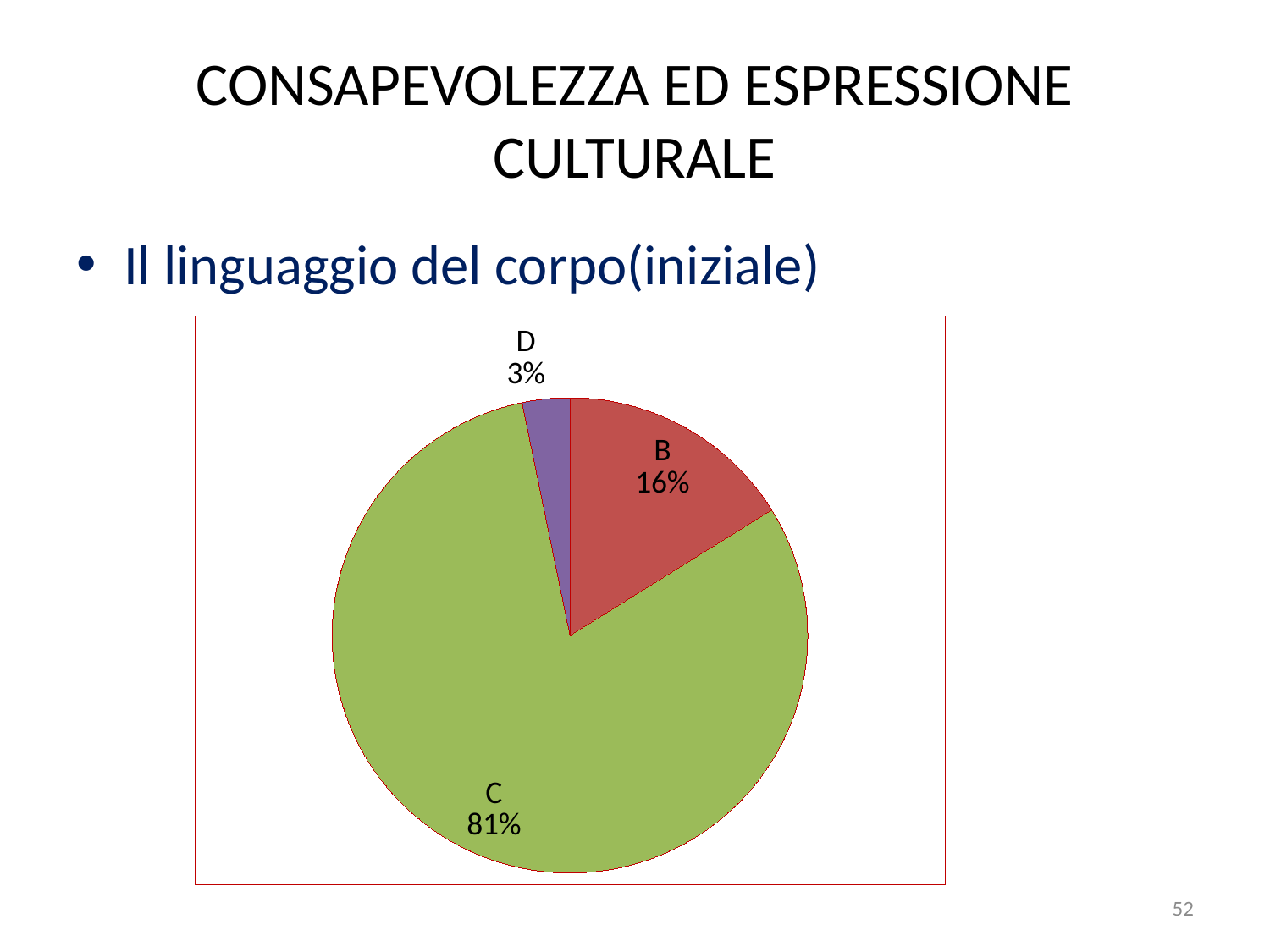
What is the difference in percentage points between slice C and slice B? 65 Which slice is the largest in the pie chart? C What colour is slice B in the pie chart? red What share of the pie does slice B have? 16% What share of the pie does slice C have? 81% What kind of chart is shown on the slide? pie chart What share of the pie does slice D have? 3% How many slices does the pie chart have? 3 What is the difference in percentage points between slice B and slice D? 13 What colour is slice C in the pie chart? green Which slice is larger, B or D? B Which slice is the smallest in the pie chart? D